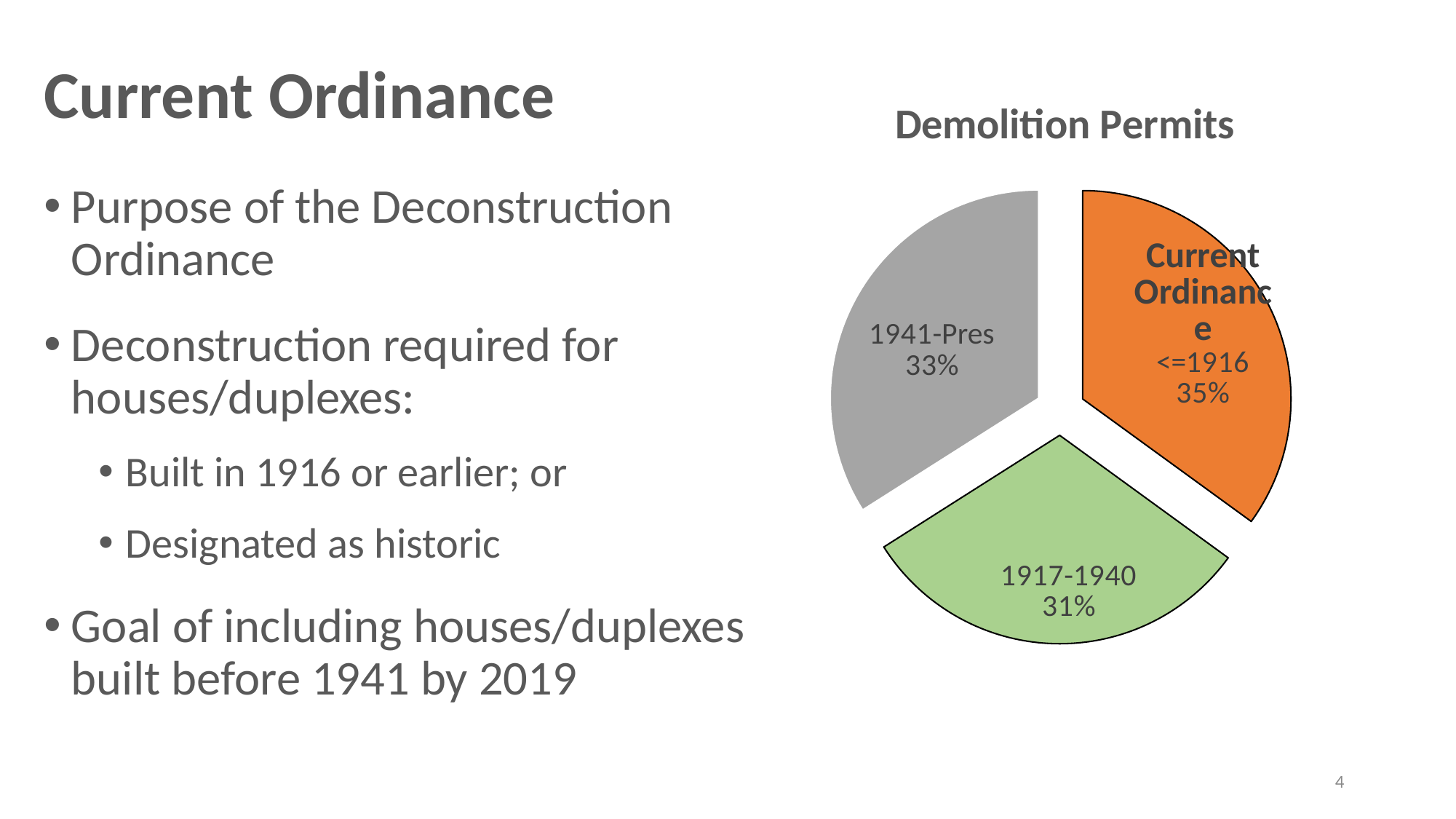
What share of demolition permits is for the 1941-Pres category? 33% What kind of chart is shown on the slide? pie chart What share of demolition permits is for the <=1916 category? 35% What is the difference in percentage points between the <=1916 share and the 1941-Pres share? 2 What is the difference in percentage points between the <=1916 share and the 1917-1940 share? 4 What is the title of the chart? Demolition Permits How many slices does the pie chart have? 3 Which category has the largest share of demolition permits? <=1916 What share of demolition permits is for the 1917-1940 category? 31% Which has a larger share, 1941-Pres or 1917-1940? 1941-Pres Which slice is labelled as covered by the Current Ordinance? <=1916 Which category has the smallest share of demolition permits? 1917-1940